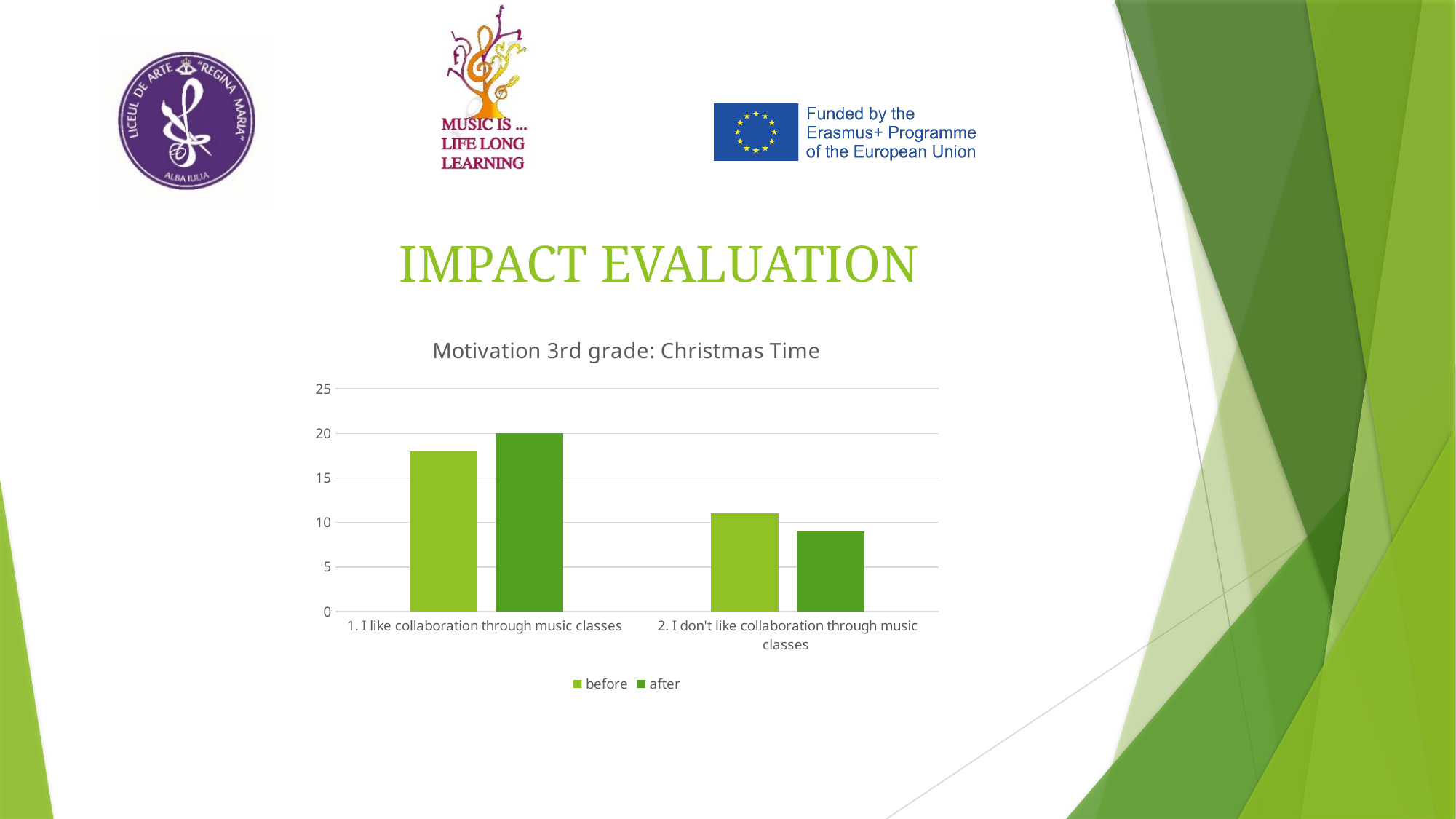
Is the 'before' value for '2. I don't like collaboration through music classes' greater or less than 10? greater Is the 'after' value for '2. I don't like collaboration through music classes' greater or less than 10? less What are the series names listed in the chart legend? before, after What kind of chart is shown on the slide? bar chart What is the title of the chart? Motivation 3rd grade: Christmas Time Which category has the lowest 'before' value? 2. I don't like collaboration through music classes Which category has the highest 'after' value? 1. I like collaboration through music classes How many series does the chart legend list? 2 Is the 'before' value for '1. I like collaboration through music classes' greater or less than 15? greater How many categories are shown on the x axis of the chart? 2 What is the 'after' value for '1. I like collaboration through music classes'? 20 For '2. I don't like collaboration through music classes', which is larger, the 'before' value or the 'after' value? before